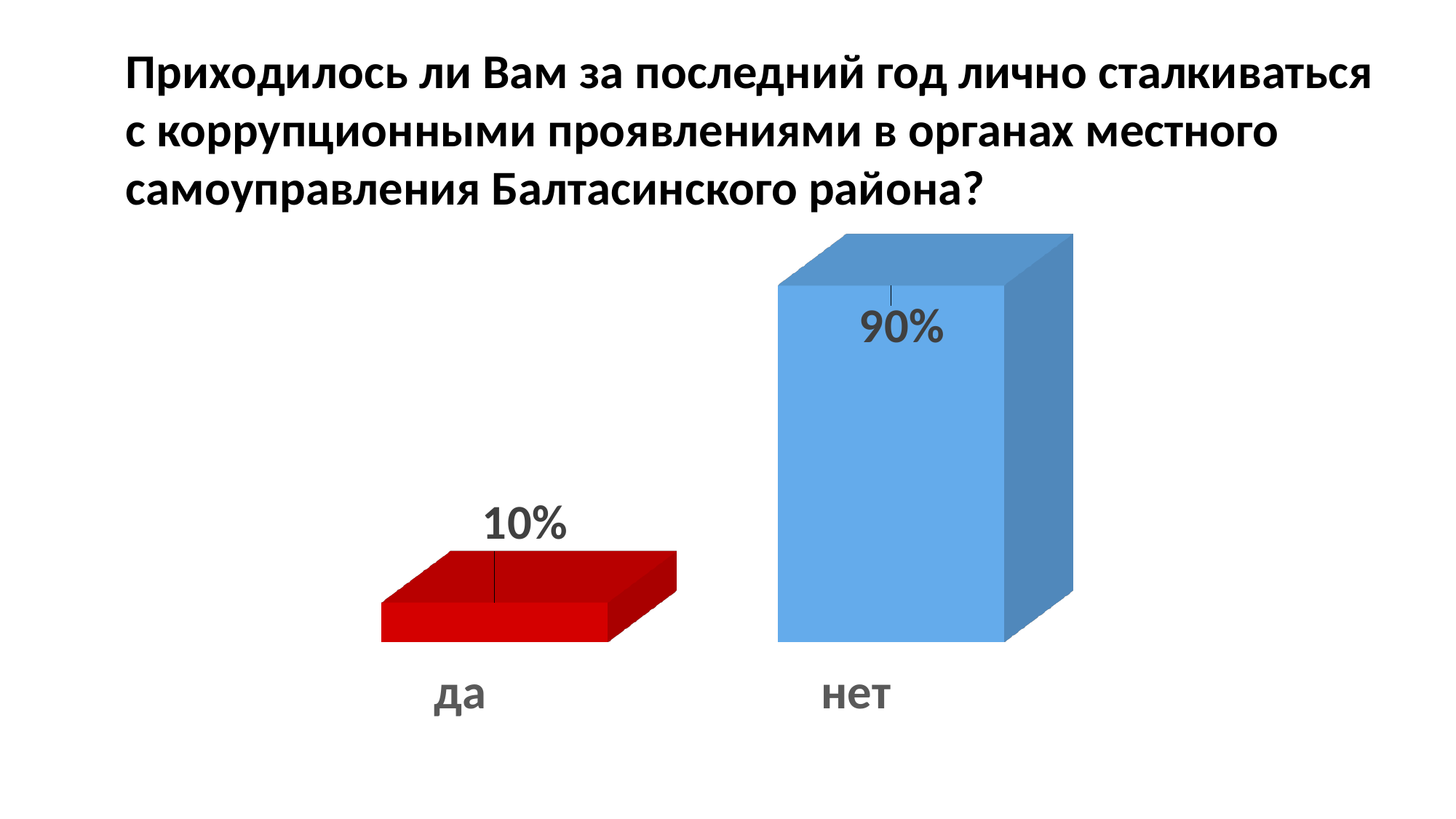
What colour is the bar for "нет"? blue What is the difference between the values for "нет" and "да"? 80% Which category has the lowest value? да What is the value for "да"? 10% What kind of chart is shown on the slide? bar chart How many categories are shown in the chart? 2 What colour is the bar for "да"? red What is the value for "нет"? 90% Which category has the highest value? нет Which is larger, the value for "да" or the value for "нет"? нет What is the total of the values for "да" and "нет"? 100%